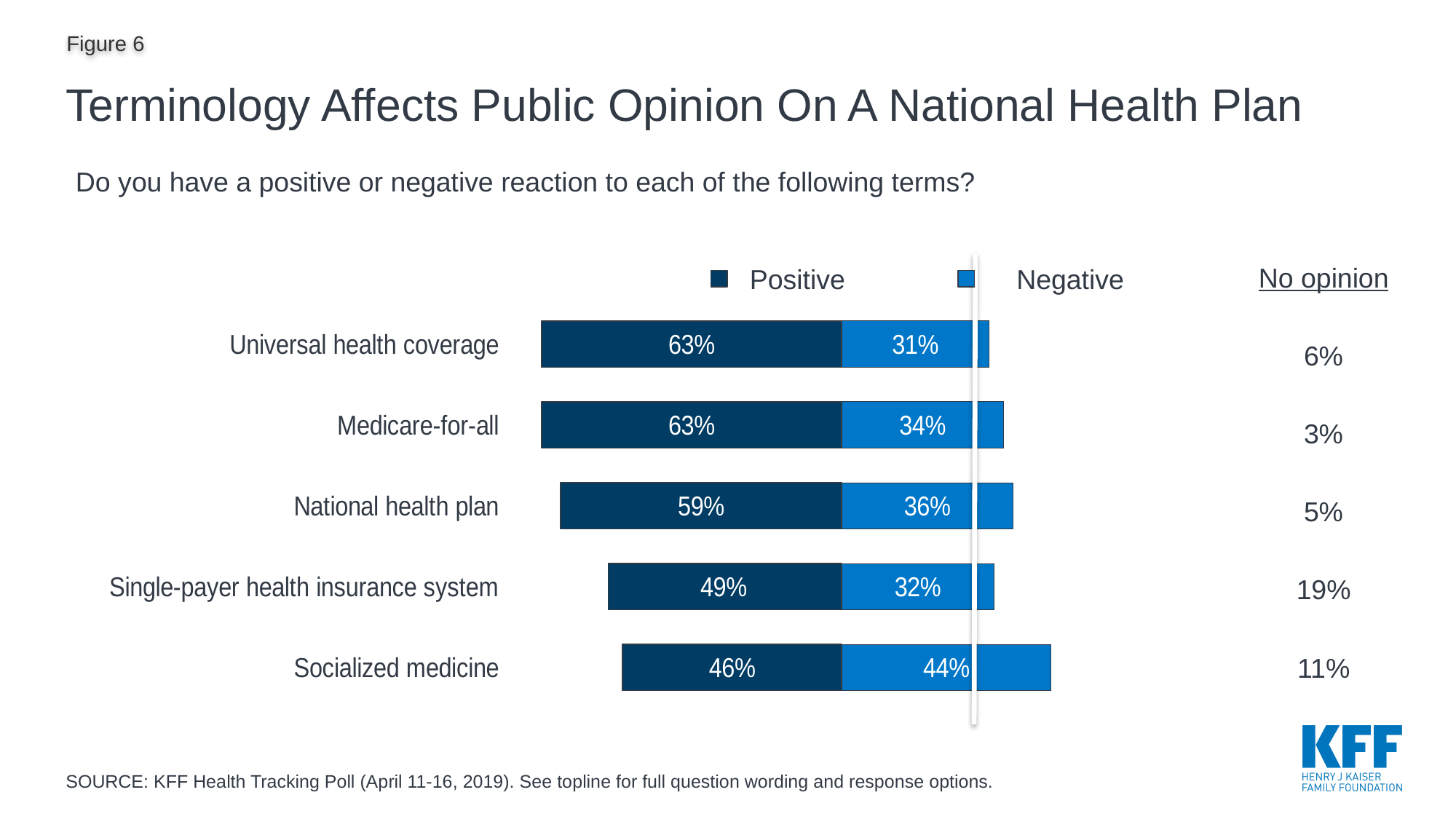
Which term has the highest negative reaction percentage? Socialized medicine What is the difference between the positive and negative reaction percentages for "National health plan"? 23 percentage points What percentage of respondents had a positive reaction to the term "Medicare-for-all"? 63% How many series does the legend list? 2 How many terms are shown in the chart? 5 Is the positive reaction percentage higher for "Single-payer health insurance system" or "Socialized medicine"? Single-payer health insurance system Which term has the lowest positive reaction percentage? Socialized medicine Which term has the lowest negative reaction percentage? Universal health coverage What percentage of respondents had a negative reaction to the term "Socialized medicine"? 44% What is the "No opinion" percentage for "Single-payer health insurance system"? 19% What type of chart is shown on the slide? Stacked bar chart What is the combined positive and negative reaction percentage for "Universal health coverage"? 94%